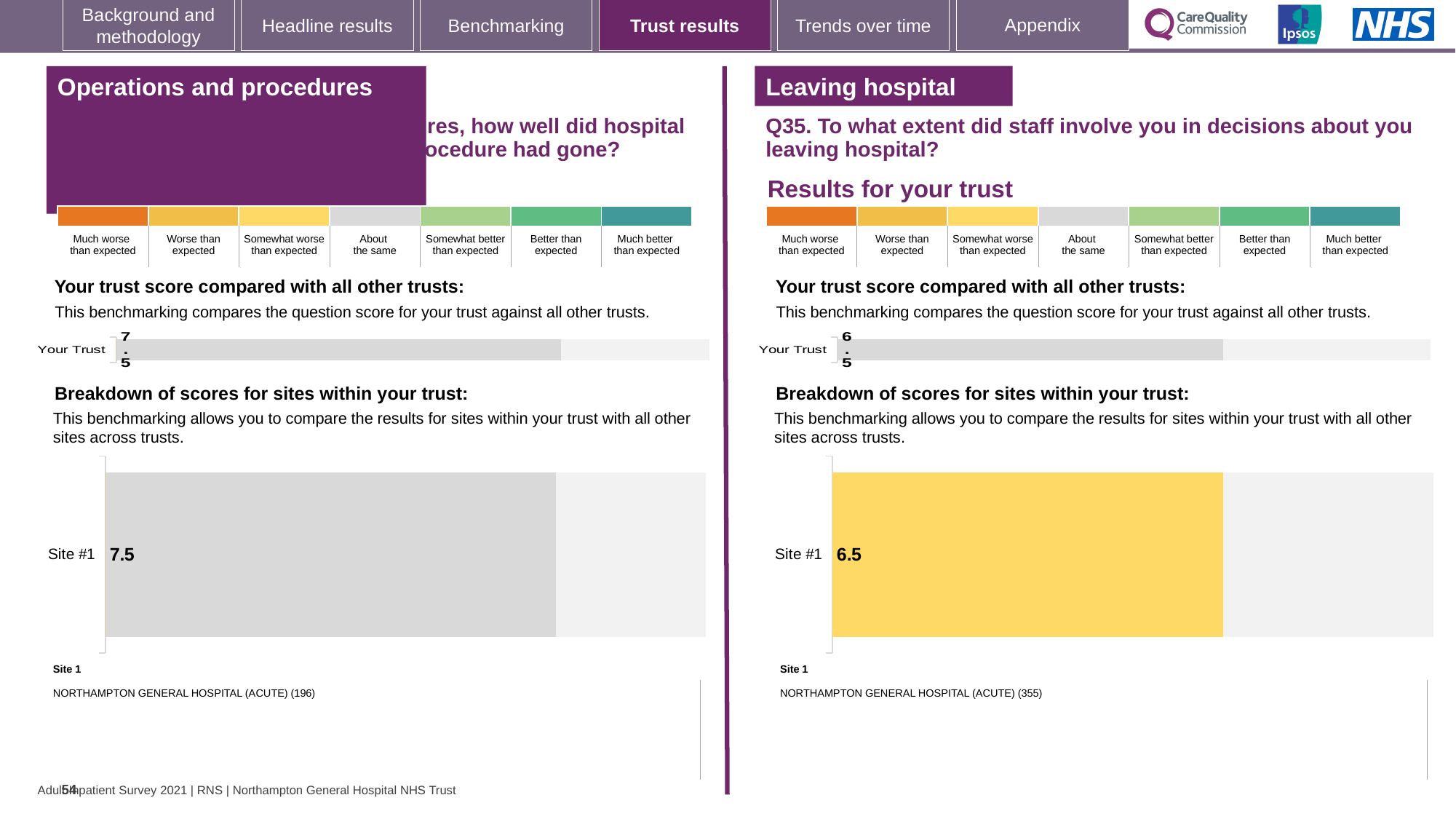
In the Operations and procedures section on the left, what is the score shown for Your Trust? 7.5 In the Operations and procedures section on the left, what score is shown for Site #1 in the breakdown of scores for sites chart? 7.5 Which is larger: the Site #1 score in the Operations and procedures section on the left or the Site #1 score in the Leaving hospital section on the right? Operations and procedures (7.5) In the Leaving hospital section on the right (Q35), what is the score shown for Your Trust? 6.5 In the Leaving hospital section on the right, which hospital is listed as Site 1 and how many respondents are shown in brackets? NORTHAMPTON GENERAL HOSPITAL (ACUTE) (355) In the Leaving hospital section on the right (Q35), what score is shown for Site #1 in the breakdown of scores for sites chart? 6.5 What type of chart is used to show the Site #1 score in the Leaving hospital section on the right? Bar chart In the Leaving hospital section on the right, which benchmark category does the colour of the Site #1 bar correspond to? Somewhat worse than expected What is the difference between the Site #1 score in the Operations and procedures section (left) and the Site #1 score in the Leaving hospital section (right)? 1.0 How many sites are shown in the breakdown of scores for sites chart in the Leaving hospital section on the right? 1 In the Operations and procedures section on the left, how many respondents are shown in brackets for Site 1, Northampton General Hospital (Acute)? 196 In the Operations and procedures section on the left, which benchmark category does the colour of the Site #1 bar correspond to? About the same